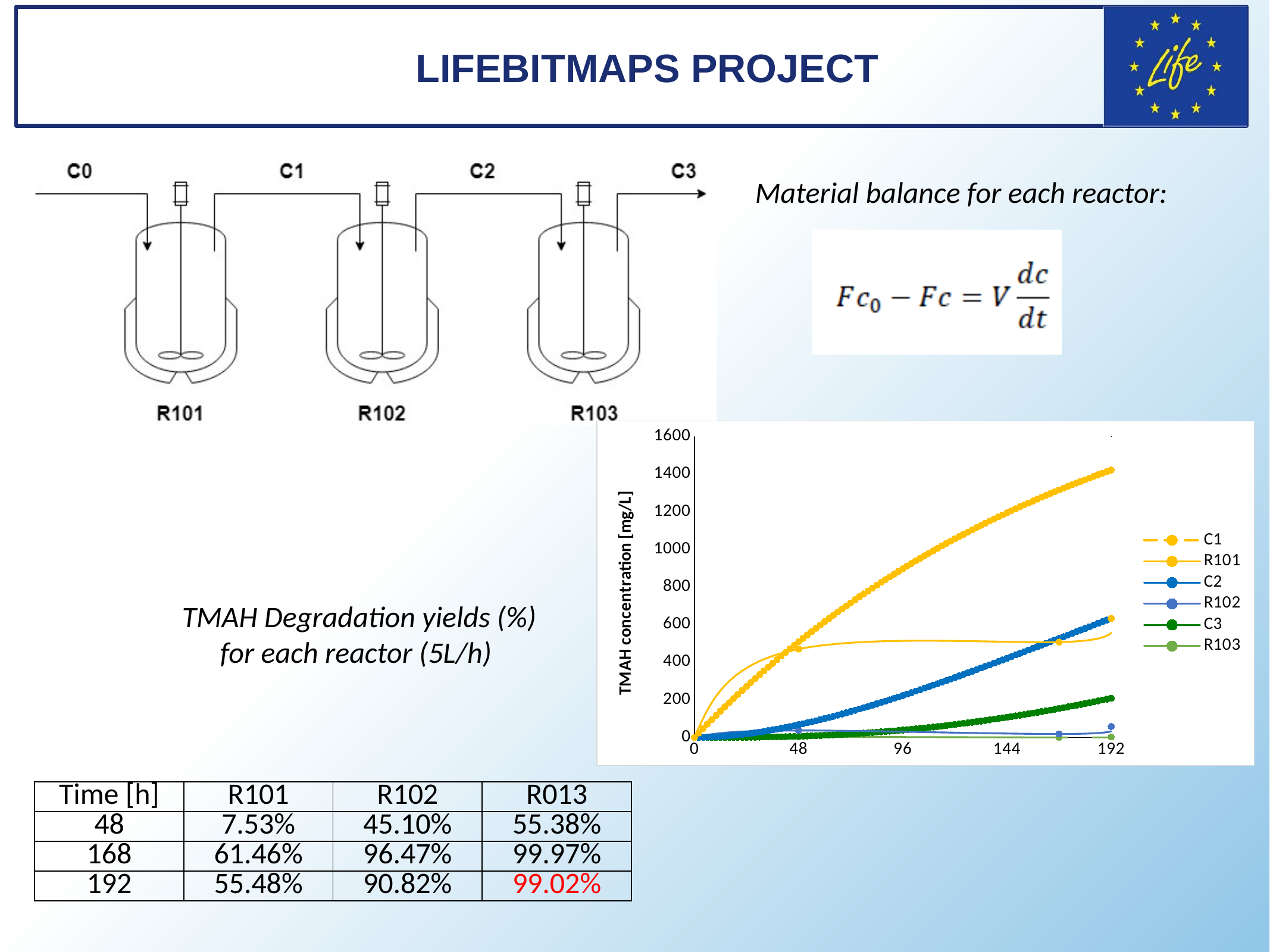
At 192 on the x axis, which is larger, C1 or C2? C1 What kind of chart is shown on the slide? line chart Is the value of C2 at 192 greater or less than 400? greater Is the value of R102 at 192 greater or less than 200? less How many series does the chart legend list? 6 What is the y-axis title of the chart? TMAH concentration [mg/L] Does the C1 series rise or fall as the x axis goes from 0 to 192? rise What is the highest value shown on the y axis of the chart? 1600 At 192 on the x axis, which is larger, C3 or R103? C3 Is the value of C2 at 192 greater or less than 800? less Which series reaches the highest TMAH concentration at 192 on the x axis? C1